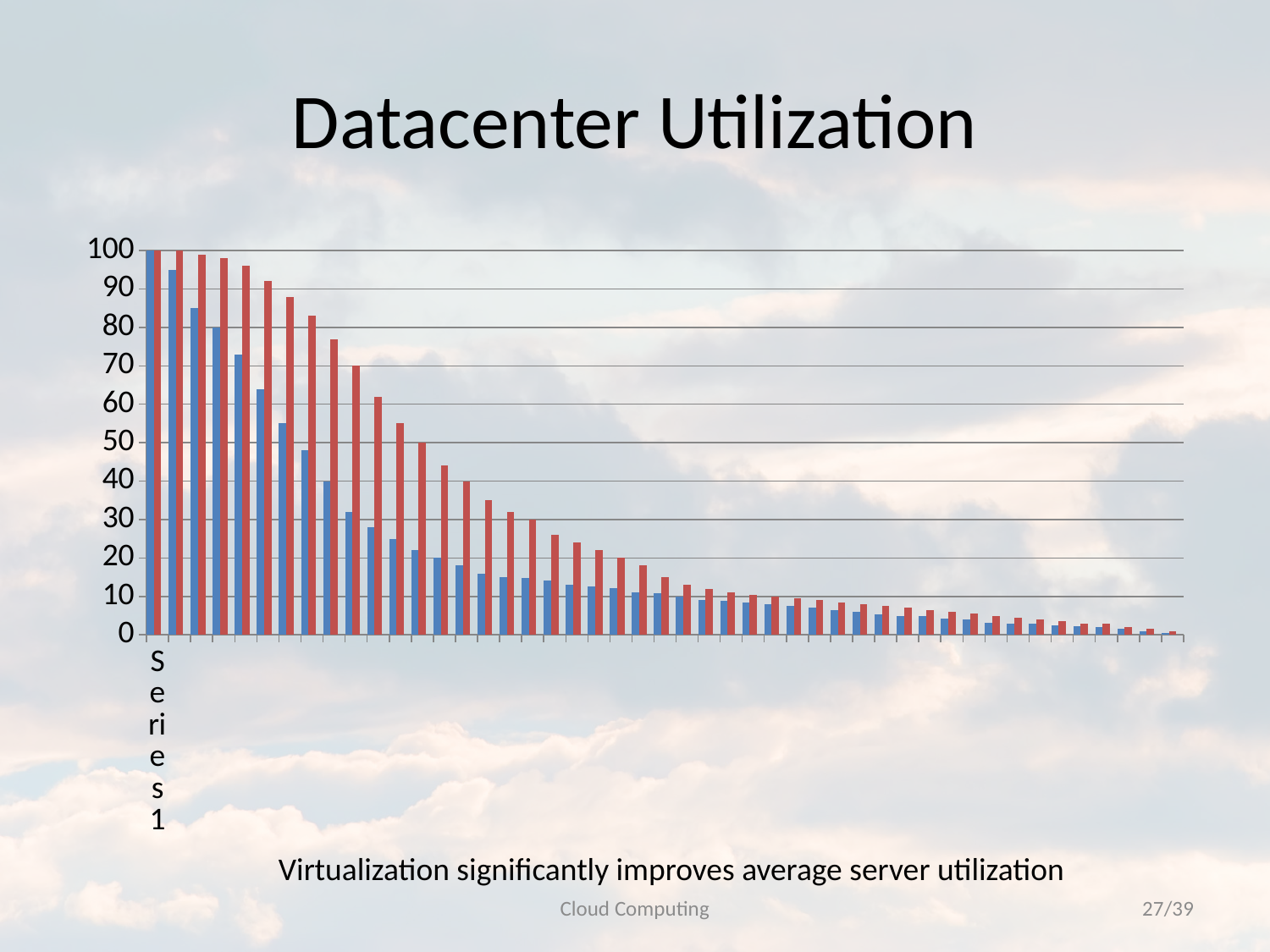
Is the value of the rightmost red bar greater or less than 10? less What is the title of the chart on the slide? Datacenter Utilization What kind of chart is shown on the slide? bar chart What is the highest value shown on the vertical axis? 100 Is the value of the second blue bar from the left greater or less than 90? greater Is the value of the leftmost blue bar greater or less than 90? greater Do the bar values rise or fall moving from left to right along the x axis? fall Which position along the x axis has the tallest bars? the leftmost position How many differently coloured bar series are plotted in the chart? 2 In the fifth pair of bars from the left, is the red bar or the blue bar taller? red